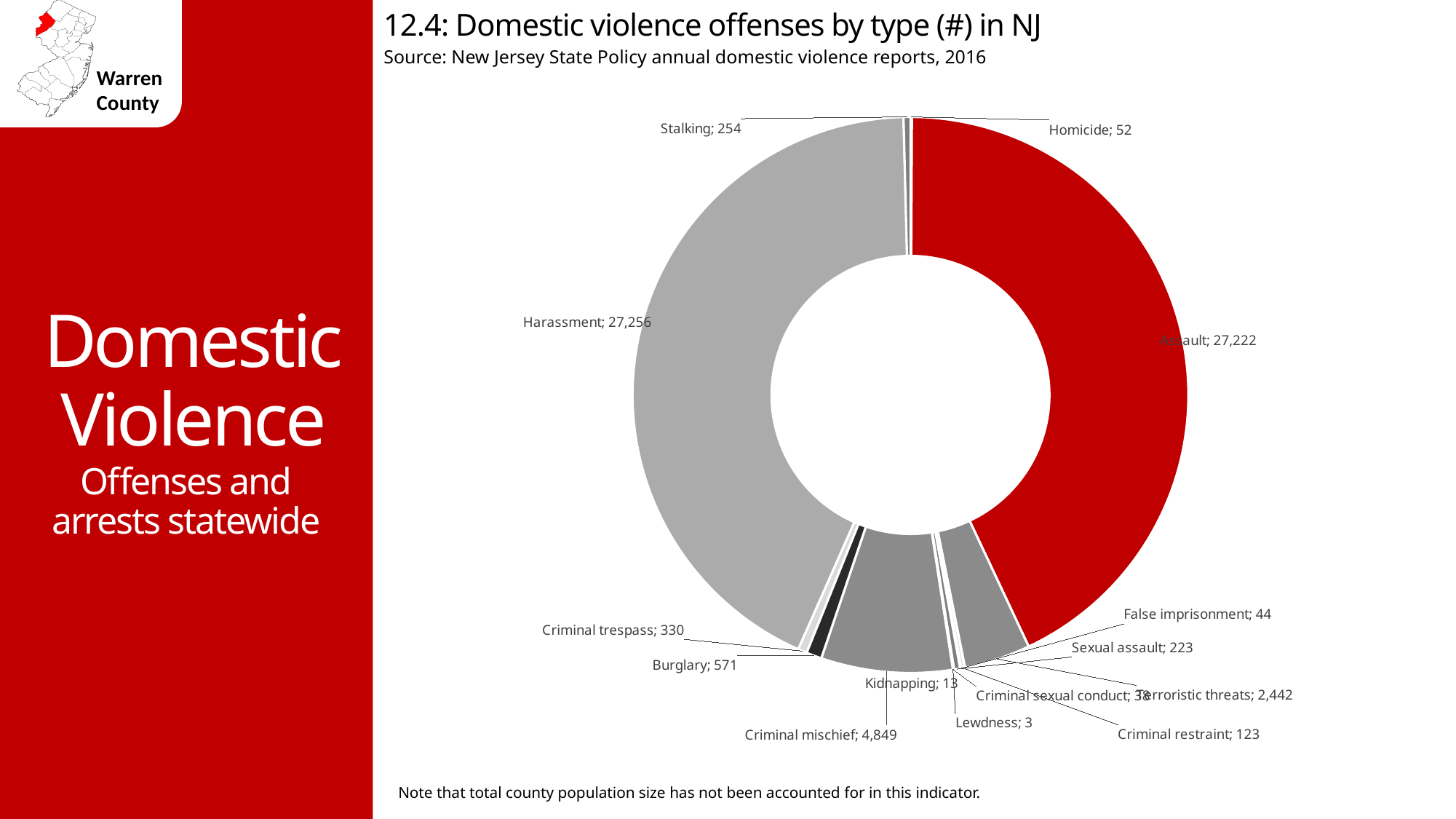
Which is larger, the value for Stalking or the value for Sexual assault? Stalking What colour is the Assault segment of the chart? red What is the difference between the values for Assault and Homicide? 27,170 How many offense types are shown in the chart? 14 What is the value for Assault? 27,222 What is the value for Harassment? 27,256 What kind of chart is shown on the slide? doughnut chart What is the difference between the values for Burglary and Criminal trespass? 241 What is the value for Criminal mischief? 4,849 What is the value for Terroristic threats? 2,442 Which offense type has the lowest value? Lewdness What is the value for Stalking? 254